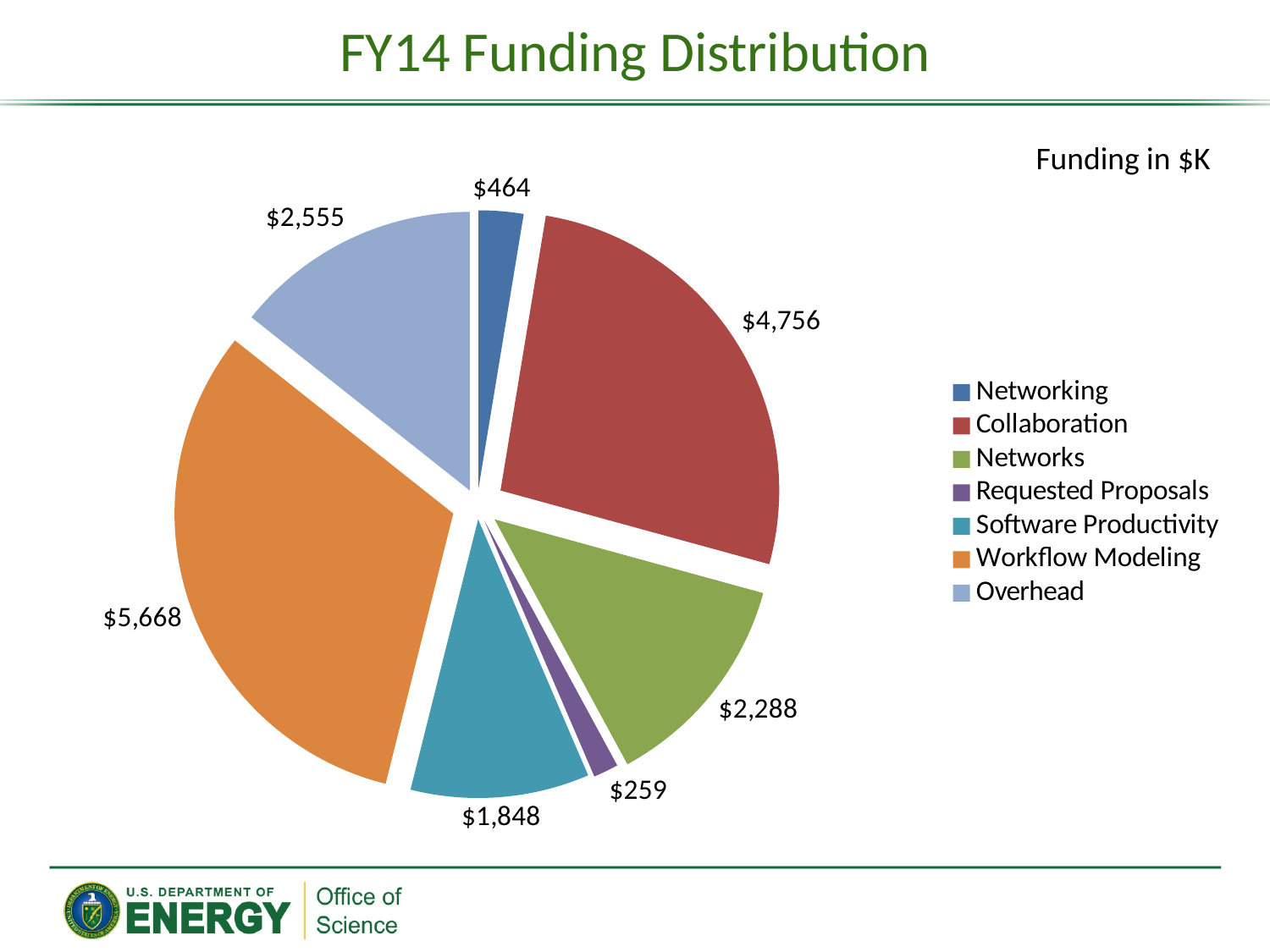
What is the funding value for Software Productivity? $1,848 Which category receives the smallest share of FY14 funding? Requested Proposals What is the funding value for Collaboration? $4,756 How many categories does the pie chart show? 7 What is the funding value for Workflow Modeling? $5,668 What kind of chart is shown on the slide? Pie chart Which has more funding, Networking or Requested Proposals? Networking Which category receives the largest share of FY14 funding? Workflow Modeling What is the difference in funding between Overhead and Networks? $267 What unit is the funding expressed in, according to the note on the slide? $K What is the difference in funding between Workflow Modeling and Collaboration? $912 What is the funding value for Requested Proposals? $259